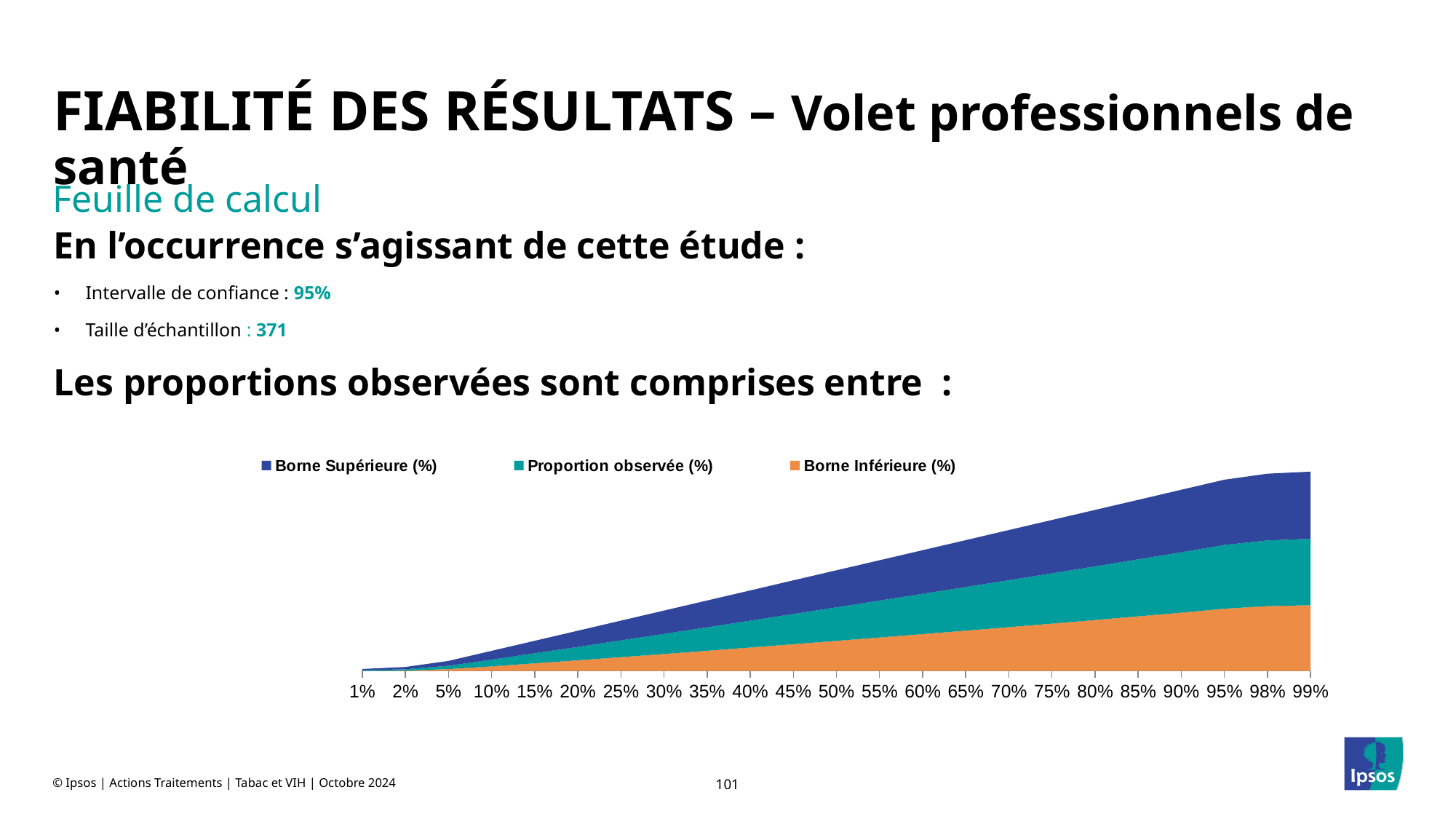
Which colour represents the series 'Borne Inférieure (%)' in the chart? Orange What is the last category label on the x axis of the chart? 99% What is the first category label on the x axis of the chart? 1% How many series does the chart's legend list? 3 Do the plotted values rise or fall as you move from left to right along the x axis? Rise How many categories are shown along the x axis of the chart? 23 Which series is listed first in the chart's legend? Borne Supérieure (%) What kind of chart is shown on the slide? Area chart